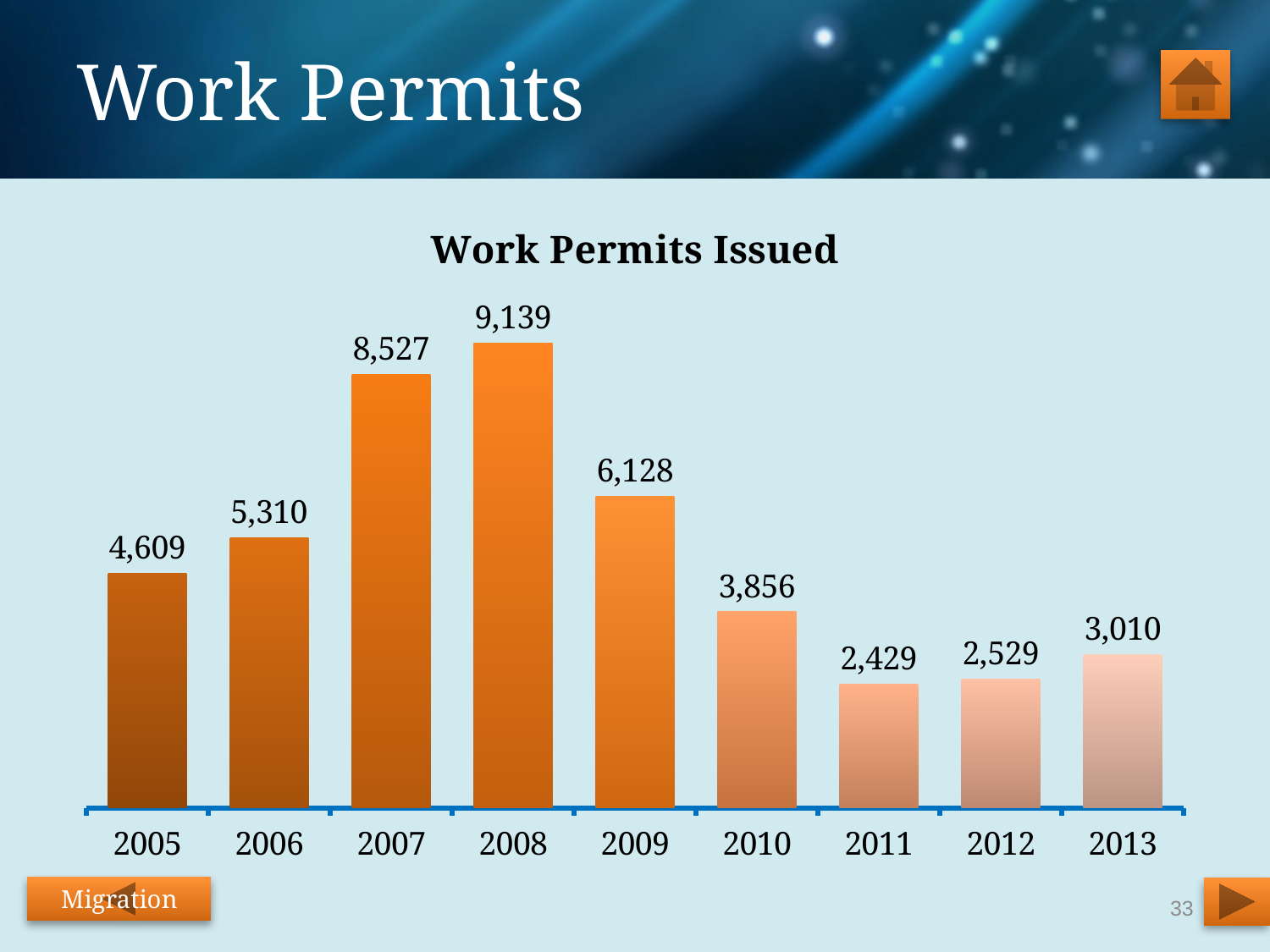
What kind of chart is this? Bar chart How many work permits were issued in 2005? 4,609 What is the difference between the values for 2013 and 2012? 481 Which year had more work permits issued, 2006 or 2009? 2009 Which year has the lowest number of work permits issued? 2011 What is the difference between the work permits issued in 2008 and 2007? 612 What is the value shown for 2011? 2,429 How many years are shown on the x axis? 9 Do the values rise or fall from 2008 to 2011? Fall Which year has the highest number of work permits issued? 2008 What is the title of the chart? Work Permits Issued How many work permits were issued in 2008? 9,139